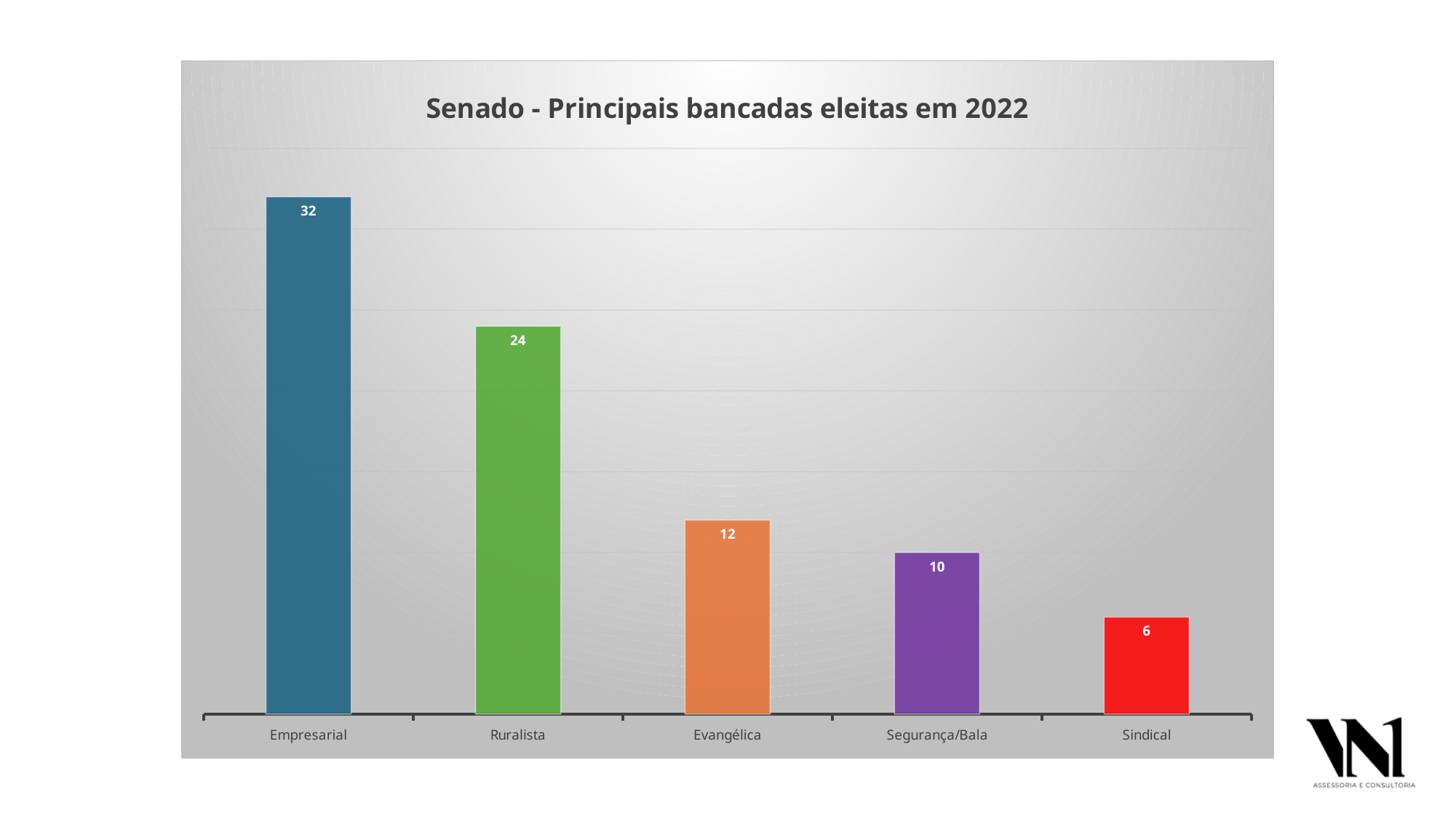
What is the value for Empresarial? 32 What is the value for Segurança/Bala? 10 What is the title of the chart? Senado - Principais bancadas eleitas em 2022 What kind of chart is shown on the slide? Bar chart How many categories are shown in the chart? 5 Which category has the highest value? Empresarial What is the difference between the values for Empresarial and Ruralista? 8 Which is larger, the value for Evangélica or the value for Segurança/Bala? Evangélica What is the value for Sindical? 6 What is the value for Ruralista? 24 Which category has the lowest value? Sindical What is the value for Evangélica? 12